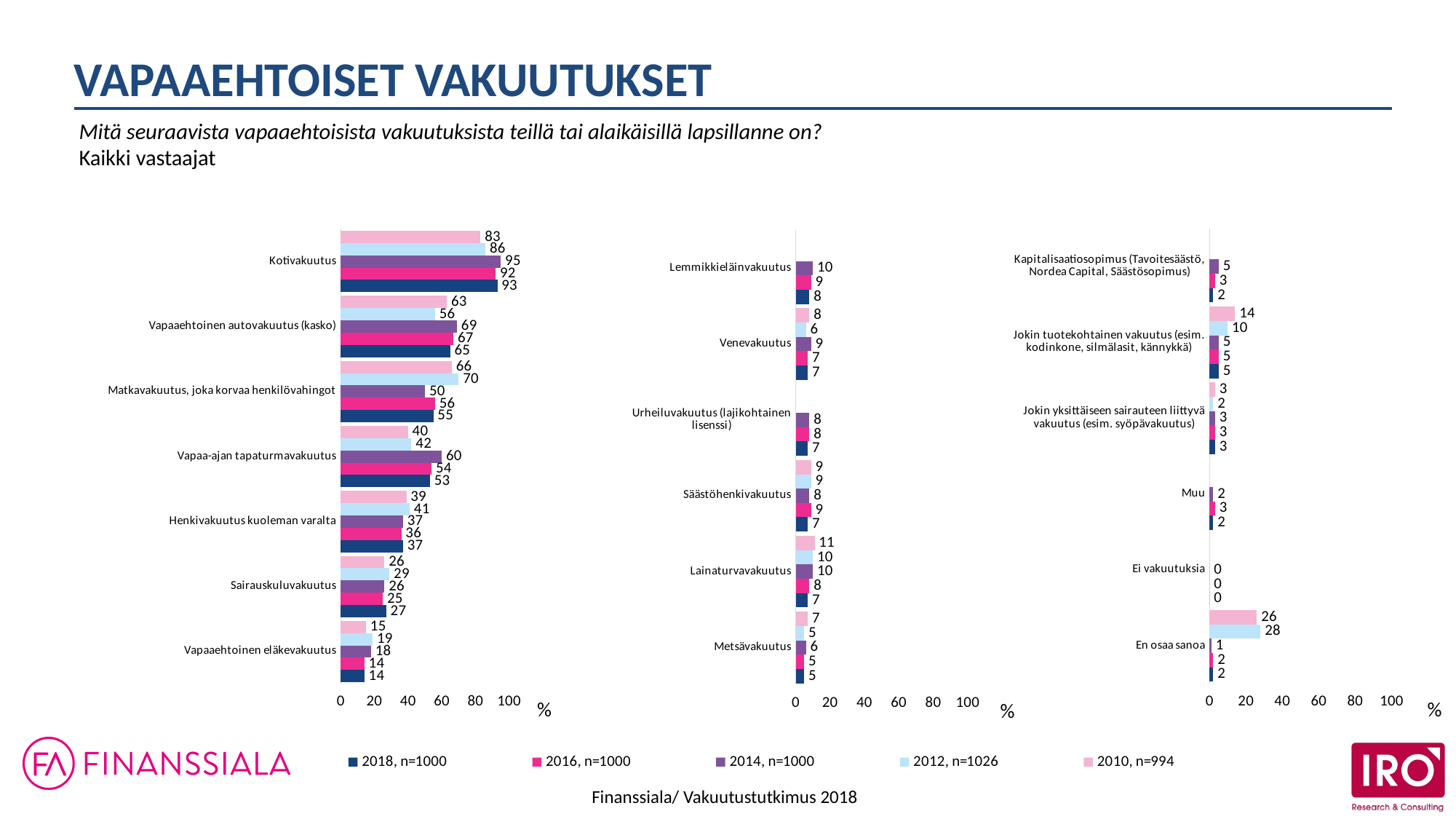
In the right chart, what is the 2010 value for Jokin tuotekohtainen vakuutus (esim. kodinkone, silmälasit, kännykkä)? 14 In the left chart, which is larger for Vapaaehtoinen autovakuutus (kasko): the 2014 value or the 2012 value? 2014 How many series does the legend list? 5 In the left chart, what is the 2012 value for Matkavakuutus, joka korvaa henkilövahingot? 70 In the left chart, which category has the lowest 2018 value? Vapaaehtoinen eläkevakuutus In the left chart, what is the 2018 value for Kotivakuutus? 93 In the right chart, what is the 2012 value for En osaa sanoa? 28 In the middle chart, what is the 2010 value for Lainaturvavakuutus? 11 In the left chart, which category has the highest 2018 value? Kotivakuutus In the middle chart, how many categories are shown? 6 What type of chart is the left chart? Bar chart In the left chart, what is the difference between the 2014 and 2010 values for Vapaa-ajan tapaturmavakuutus? 20